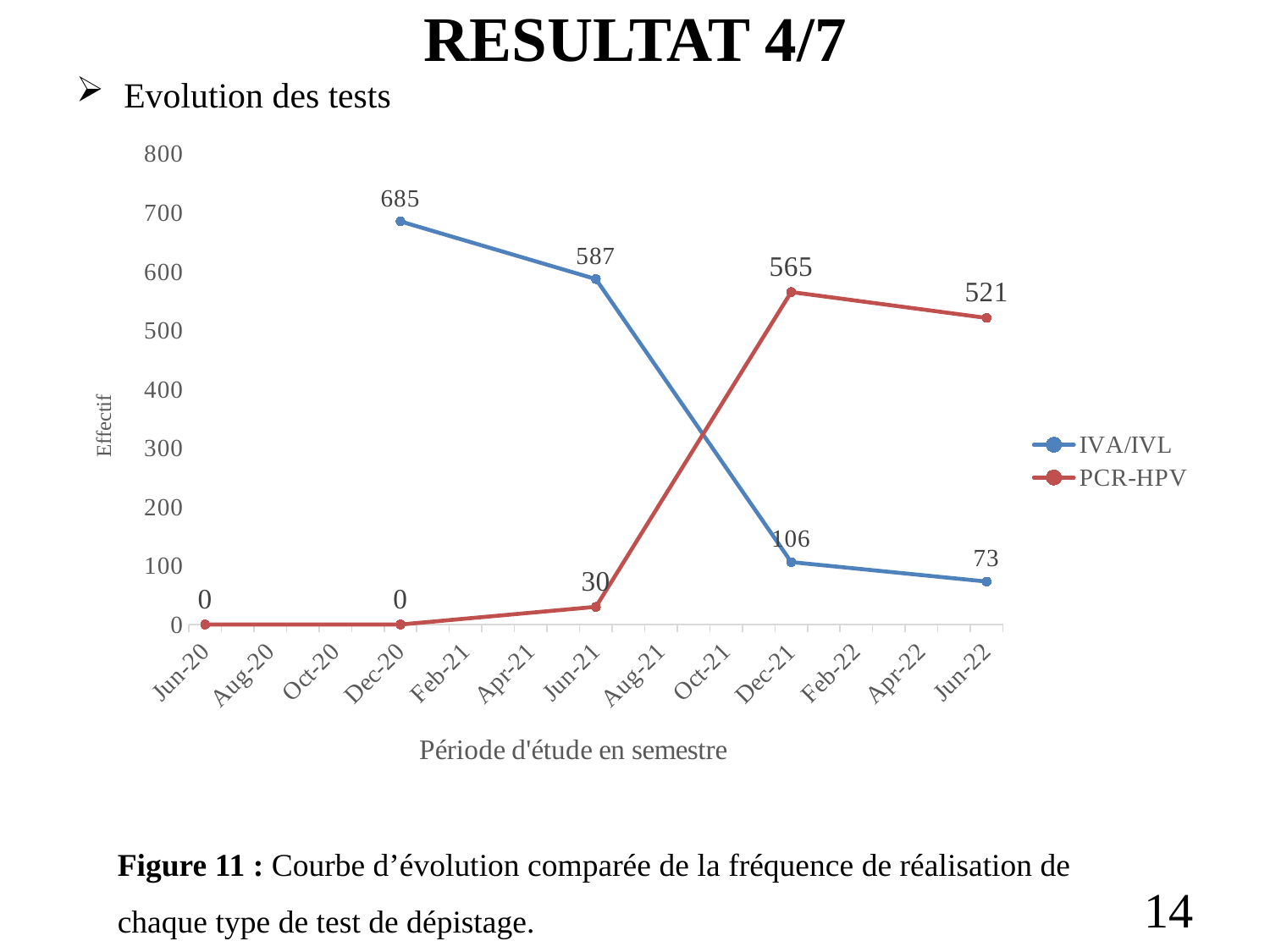
What is the value for IVA/IVL at Dec-20? 685 How many series does the legend list? 2 Which series has the larger value at Jun-22, IVA/IVL or PCR-HPV? PCR-HPV What is the value for PCR-HPV at Dec-21? 565 What is the value for PCR-HPV at Jun-21? 30 What is the difference between the IVA/IVL value at Dec-20 and at Jun-21? 98 At which period does the IVA/IVL series reach its highest value? Dec-20 What type of chart is shown on the slide? line chart What is the value for IVA/IVL at Jun-22? 73 Does the IVA/IVL series rise or fall from Dec-20 to Jun-22? fall At which period does the PCR-HPV series reach its highest value? Dec-21 What is the label of the y axis? Effectif